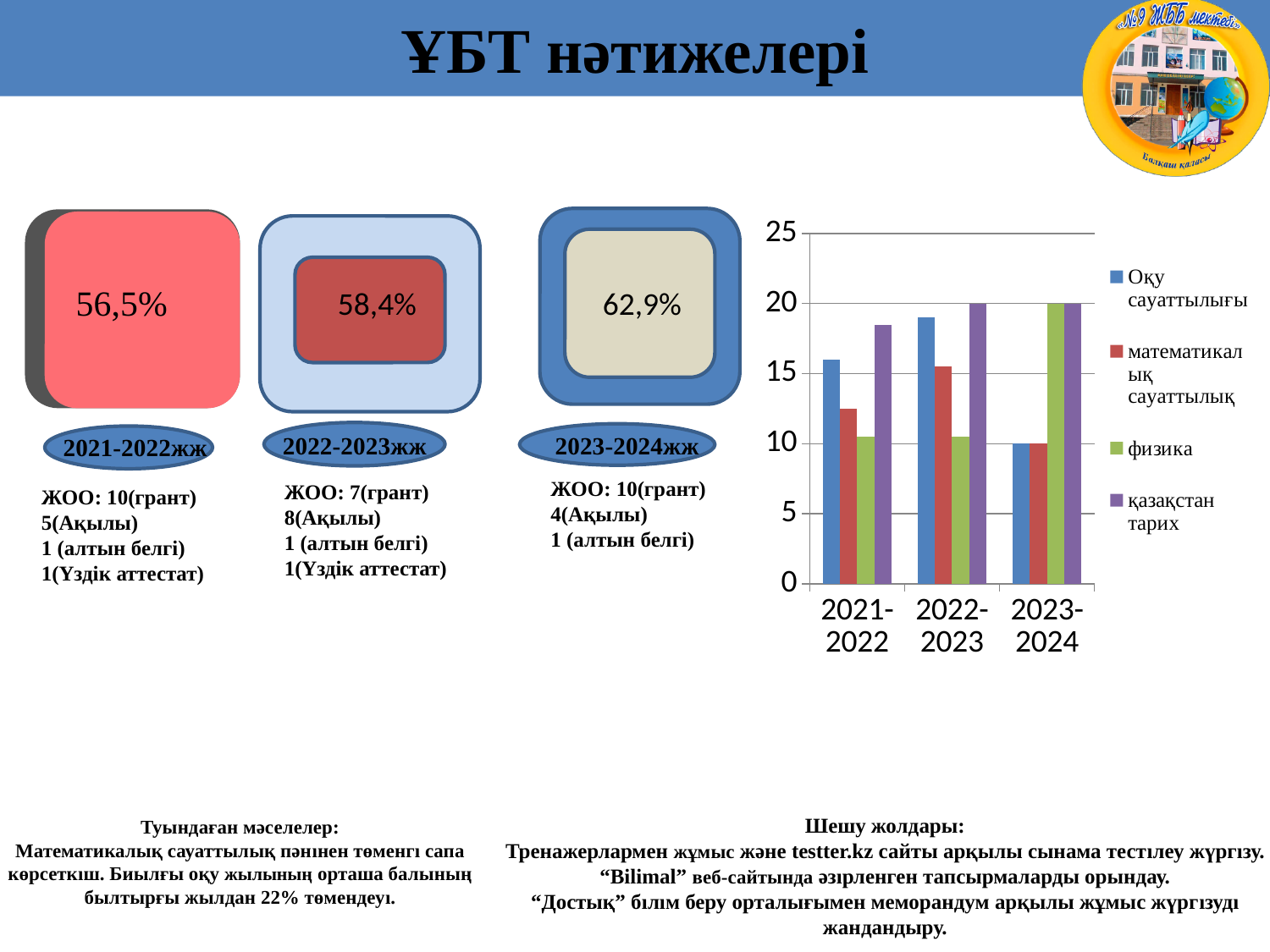
Does the физика value rise or fall from 2022-2023 to 2023-2024? rises In which academic year is the физика bar the highest? 2023-2024 What colour represents физика in the chart legend? green How many academic years are shown on the x axis of the chart? 3 Is the value for физика in 2021-2022 greater or less than 15? less What kind of chart is shown on the slide? bar chart How many series does the chart legend list? 4 What is the value for физика in 2023-2024? 20 Which is larger: физика in 2023-2024 or физика in 2021-2022? физика in 2023-2024 In 2021-2022, which is larger: қазақстан тарих or математикалық сауаттылық? қазақстан тарих Is the value for Оқу сауаттылығы in 2021-2022 greater or less than 15? greater Is the value for математикалық сауаттылық in 2021-2022 greater or less than 15? less